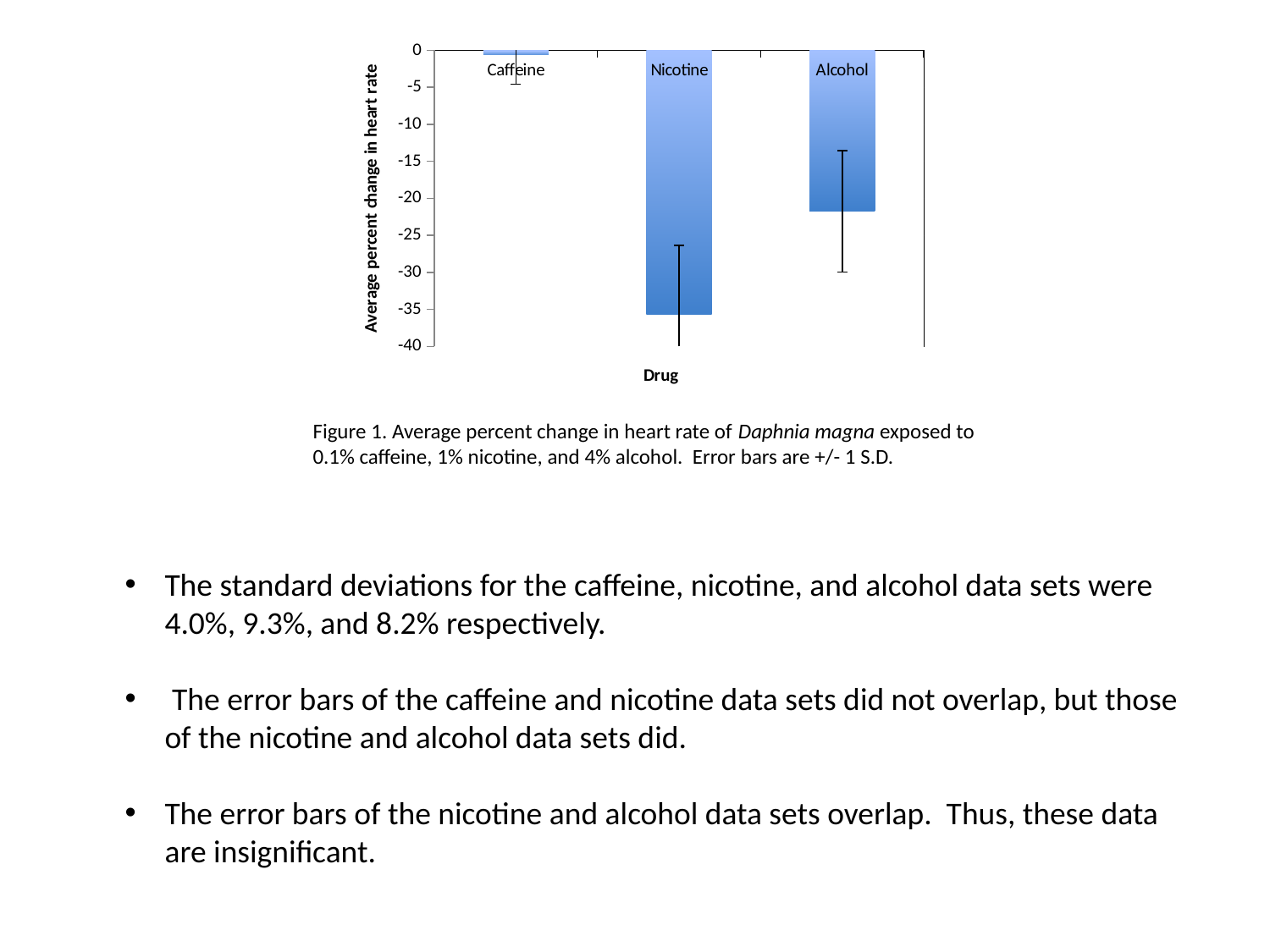
Is the value for Alcohol greater or less than -10? less What is the title of the horizontal axis of the chart? Drug Which drug has the highest (closest to zero) average percent change in heart rate? Caffeine Which has the larger (less negative) value, Nicotine or Alcohol? Alcohol What kind of chart is shown on the slide? bar chart Which has the larger (less negative) value, Caffeine or Alcohol? Caffeine Which drug has the lowest (most negative) average percent change in heart rate? Nicotine Is the value for Alcohol greater or less than -25? greater How many drug categories are plotted in the chart? 3 Is the value for Nicotine greater or less than -30? less What is the title of the vertical axis of the chart? Average percent change in heart rate